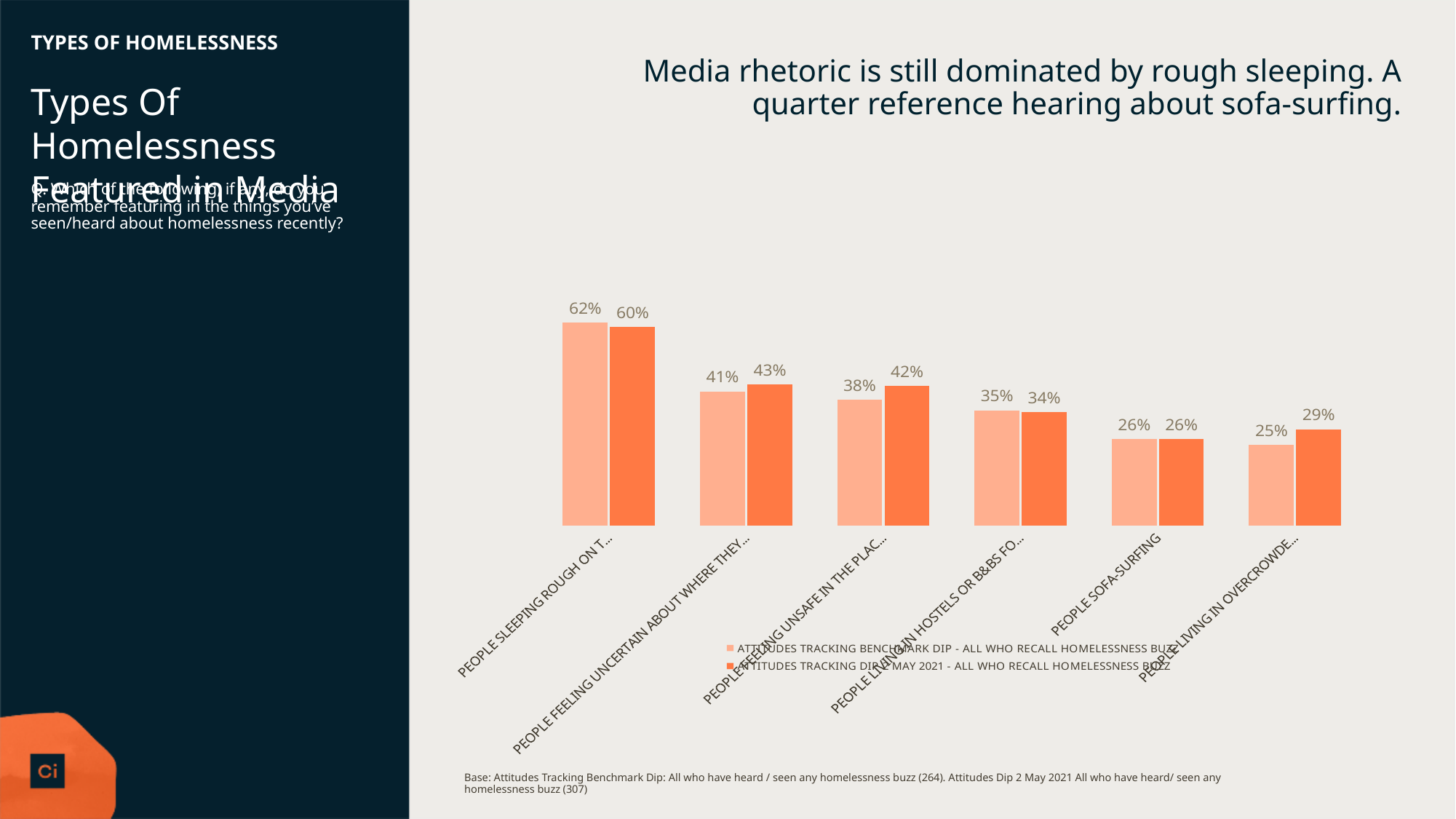
What is the difference between the Benchmark Dip and May 2021 values for people feeling unsafe in the place they live? 4% Which colour represents the May 2021 series in the chart? Dark orange What kind of chart is shown on the slide? bar chart Which category has the lowest value in the May 2021 series? People sofa-surfing What is the May 2021 value for people sofa-surfing? 26% How many series does the chart's legend list? 2 What is the May 2021 value for people living in overcrowded accommodation? 29% Do the Benchmark Dip values rise or fall moving from left to right across the categories? fall For people feeling uncertain about where they will live, which series has the larger value: Benchmark Dip or May 2021? May 2021 What is the Benchmark Dip value for people sleeping rough? 62% Which category has the highest value in the Benchmark Dip series? People sleeping rough How many categories are plotted on the chart? 6